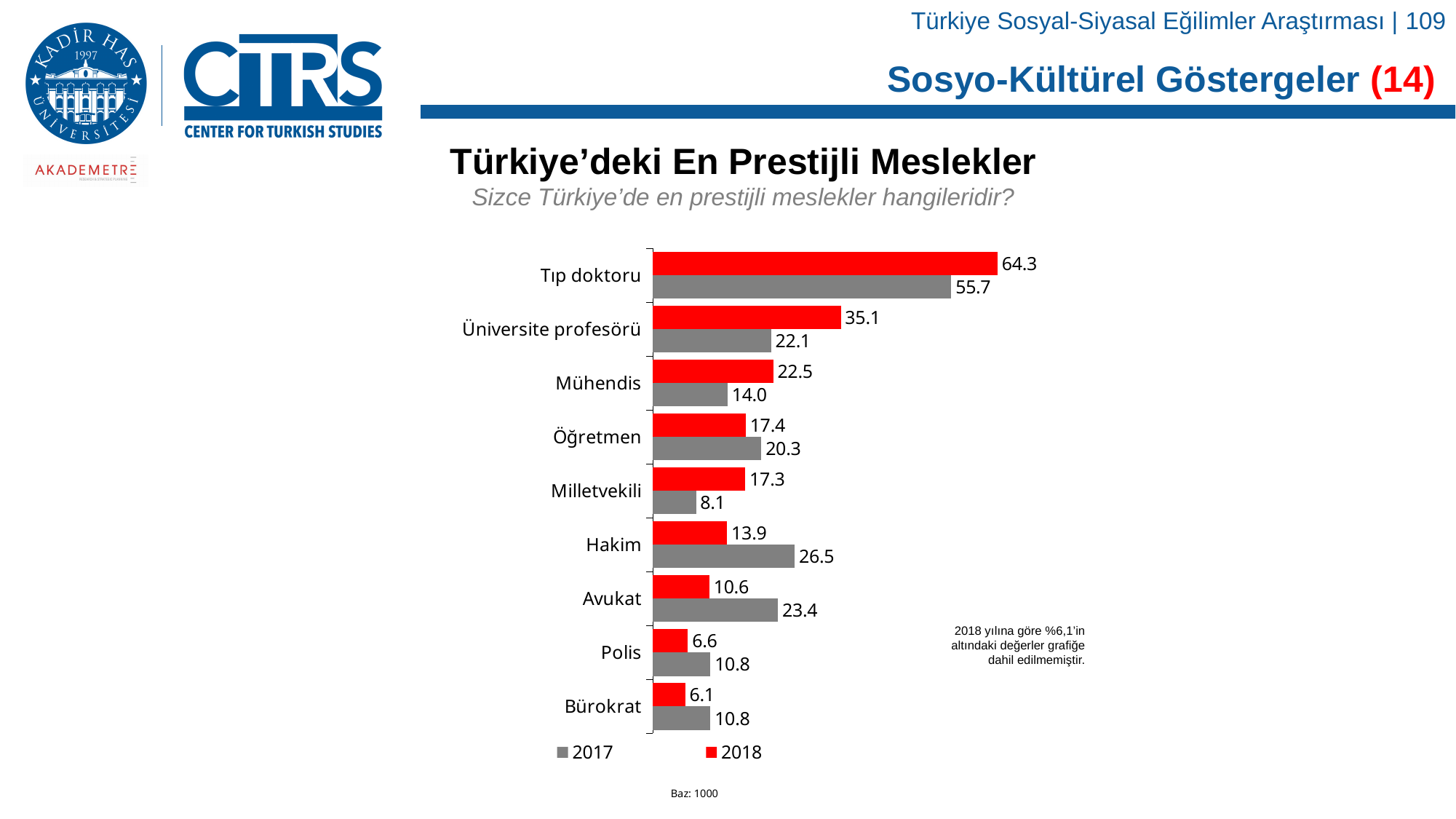
For Öğretmen, which year has the larger value, 2017 or 2018? 2017 How many professions are shown in the chart? 9 Which profession has the lowest 2017 value? Milletvekili What is the 2018 value for Milletvekili? 17.3 What is the difference between the 2018 and 2017 values for Üniversite profesörü? 13.0 Which profession has the lowest 2018 value? Bürokrat Which profession has the highest 2018 value? Tıp doktoru How many series does the legend list? 2 What is the difference between the 2017 and 2018 values for Avukat? 12.8 What is the 2018 value for Tıp doktoru? 64.3 What is the 2017 value for Hakim? 26.5 What type of chart is shown on the slide? Bar chart